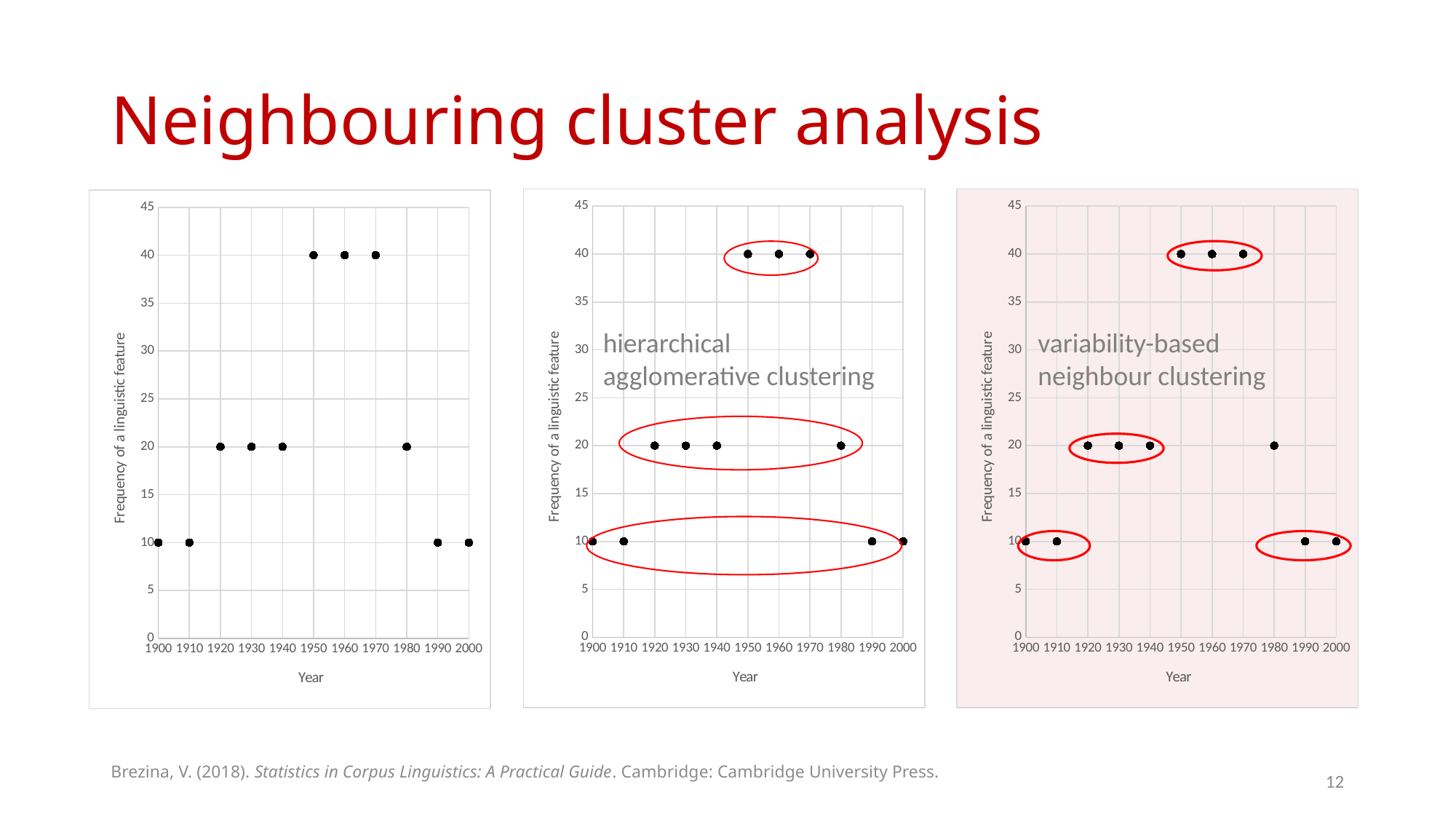
In the left chart, which years have the highest frequency? 1950, 1960 and 1970 In the left chart, what is the frequency of the linguistic feature in 1900? 10 What kind of chart is the left chart? Scatter chart In the left chart, what is the frequency of the linguistic feature in 1980? 20 In the left chart, what is the frequency of the linguistic feature in 1960? 40 In the left chart, what is the difference between the frequency in 1950 and the frequency in 1920? 20 What is the label of the x axis in the middle chart? Year How many data points are plotted in the left chart? 11 How many red ellipses (clusters) are drawn on the right chart? 4 In the left chart, does the frequency rise or fall from 1970 to 2000? Fall In the right chart, what is the frequency of the linguistic feature in 2000? 10 In the left chart, which is larger: the frequency in 1940 or the frequency in 1990? 1940